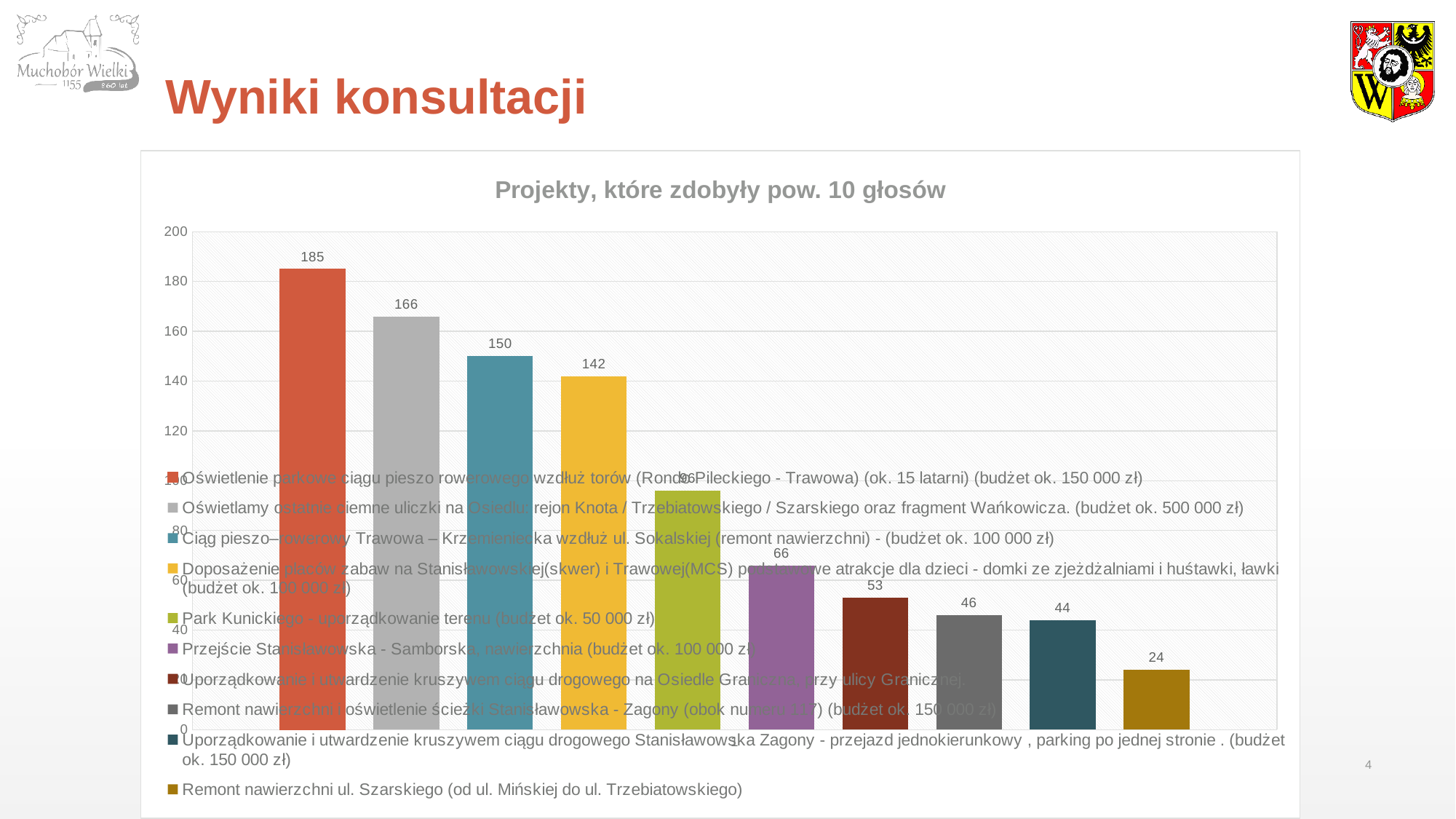
Which is larger: the value for 'Przejście Stanisławowska - Samborska, nawierzchnia' or the value for 'Remont nawierzchni i oświetlenie ścieżki Stanisławowska - Zagony'? Przejście Stanisławowska - Samborska, nawierzchnia What is the value for 'Remont nawierzchni ul. Szarskiego (od ul. Mińskiej do ul. Trzebiatowskiego)'? 24 Which project has the lowest value in the chart? Remont nawierzchni ul. Szarskiego (od ul. Mińskiej do ul. Trzebiatowskiego) What is the value for the project 'Oświetlenie parkowe ciągu pieszo rowerowego wzdłuż torów'? 185 How many entries does the chart legend list? 10 How many bars are plotted in the chart? 10 Which project has the highest value in the chart? Oświetlenie parkowe ciągu pieszo rowerowego wzdłuż torów (Rondo Pileckiego - Trawowa) Do the bar values rise or fall from left to right across the chart? fall What is the title of the chart? Projekty, które zdobyły pow. 10 głosów What is the value for 'Ciąg pieszo–rowerowy Trawowa – Krzemieniecka wzdłuż ul. Sokalskiej'? 150 What is the difference between the highest value (185) and the second highest value (166)? 19 What kind of chart is shown on the slide? bar chart